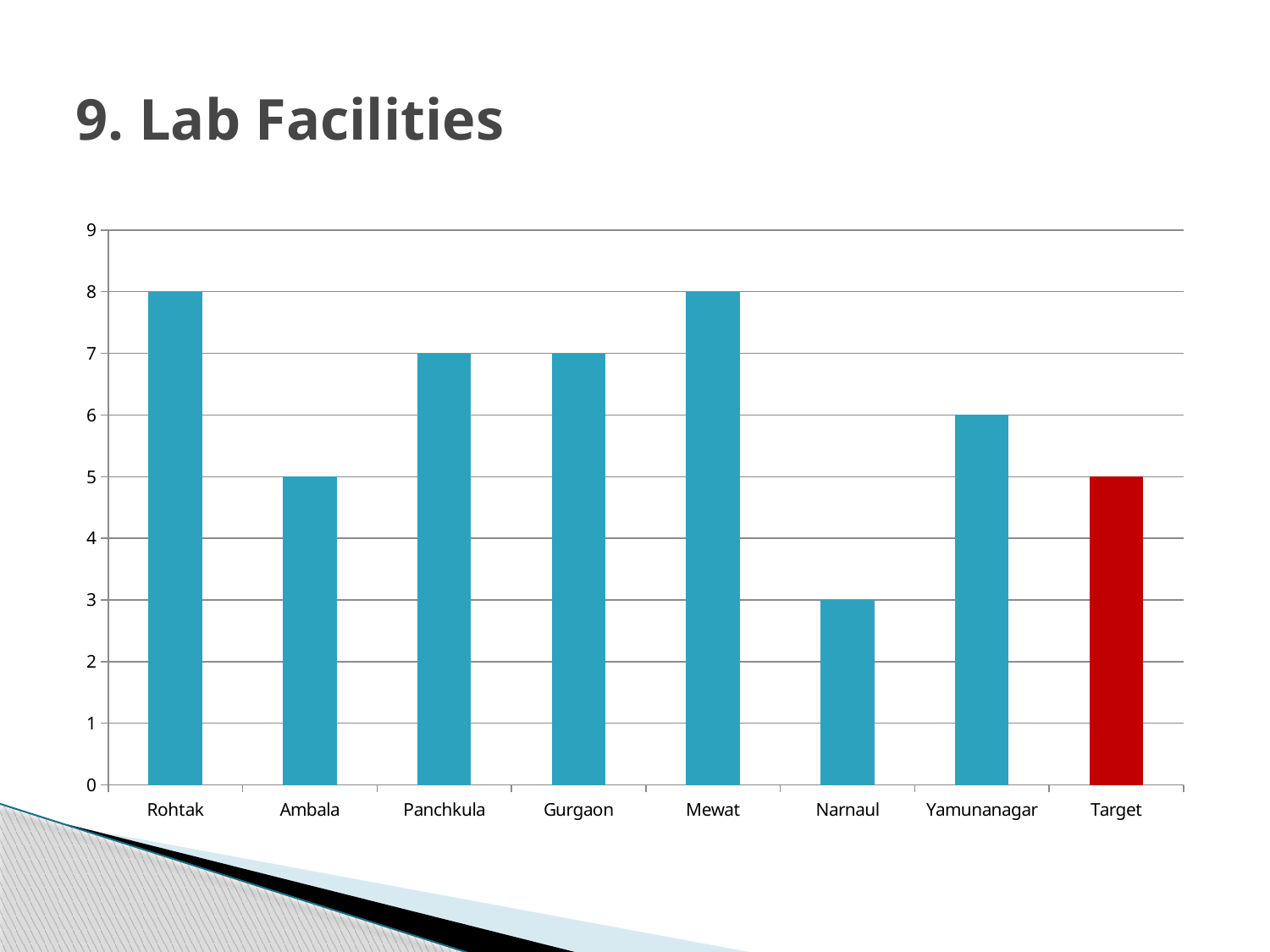
Which is larger, the value for Panchkula or the value for Ambala? Panchkula What kind of chart is shown on the slide? bar chart Is the value for Mewat greater or less than 5? greater What is the difference between the values for Yamunanagar and Target? 1 What is the difference between the values for Rohtak and Narnaul? 5 How many categories are shown on the x axis? 8 What is the value for Ambala? 5 What is the value for Yamunanagar? 6 Which category has the lowest value? Narnaul What is the value for Narnaul? 3 Which bar is coloured red rather than blue? Target What is the value for the Target bar? 5